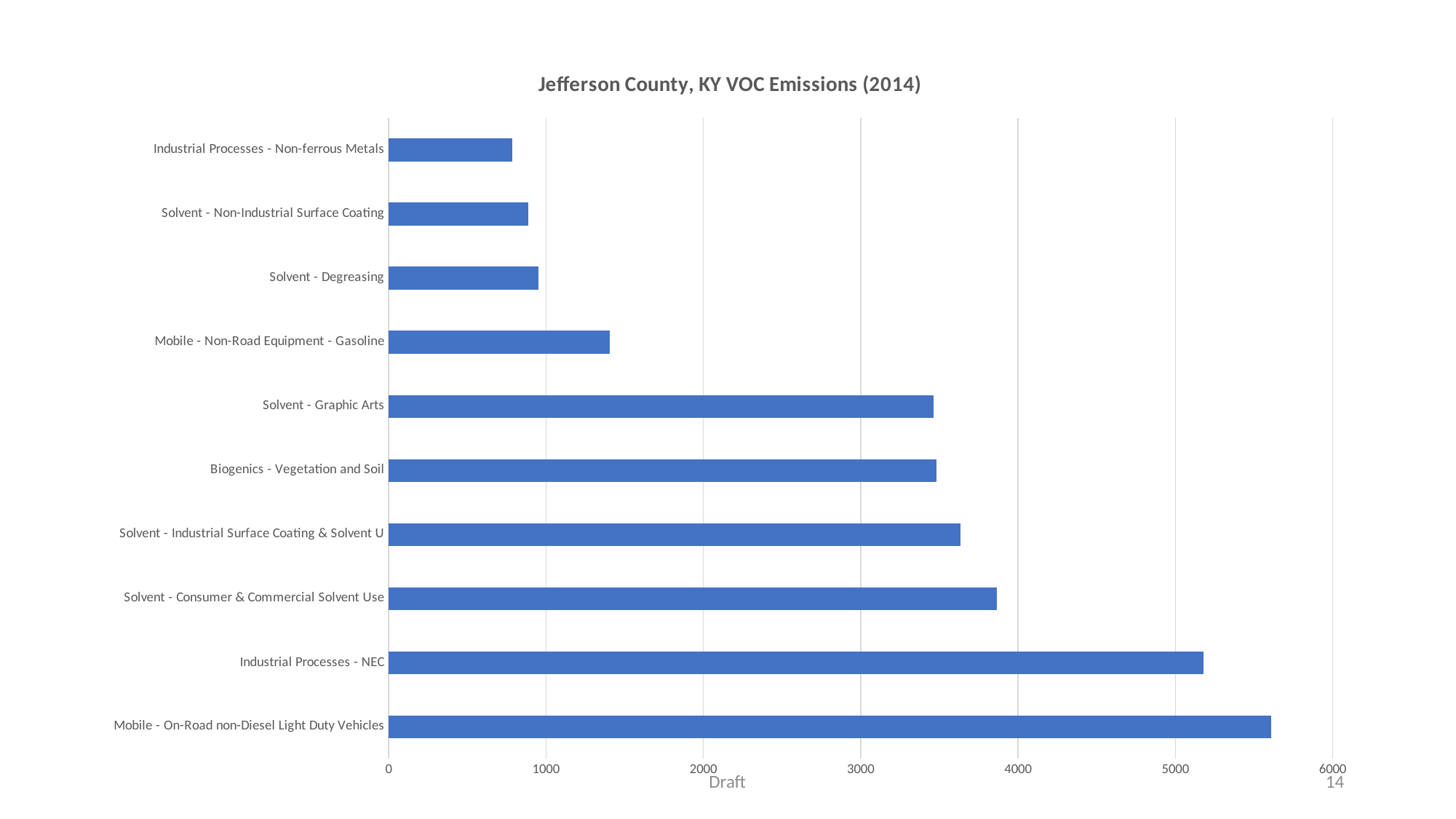
Is the value for Industrial Processes - NEC greater or less than 5000? greater Which is larger: the value for Industrial Processes - NEC or the value for Solvent - Consumer & Commercial Solvent Use? Industrial Processes - NEC Is the value for Mobile - Non-Road Equipment - Gasoline greater or less than 1000? greater Is the value for Solvent - Degreasing greater or less than 1000? less Which is larger: the value for Mobile - Non-Road Equipment - Gasoline or the value for Solvent - Degreasing? Mobile - Non-Road Equipment - Gasoline Which category has the lowest VOC emissions? Industrial Processes - Non-ferrous Metals How many categories are plotted in the chart? 10 What type of chart is shown on the slide? Bar chart What is the title of the chart? Jefferson County, KY VOC Emissions (2014) Which category has the highest VOC emissions? Mobile - On-Road non-Diesel Light Duty Vehicles